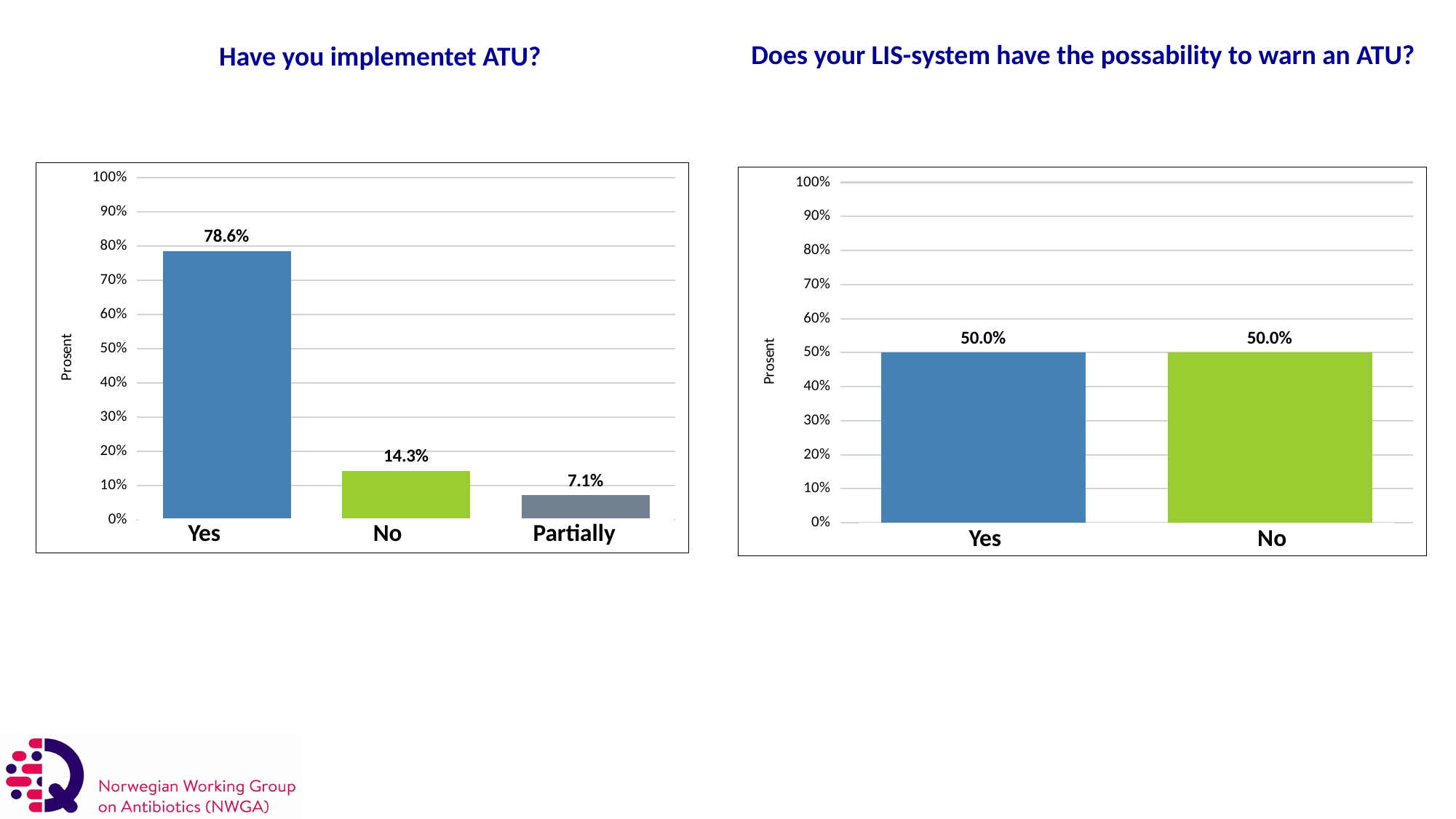
In the 'Have you implementet ATU?' chart, which category has the lowest value? Partially In the 'Does your LIS-system have the possability to warn an ATU?' chart, what is the difference between the values for Yes and No? 0.0% In the 'Have you implementet ATU?' chart, what is the difference between the values for Yes and No? 64.3% In the 'Have you implementet ATU?' chart, what is the value for Yes? 78.6% What is the y-axis label of the 'Have you implementet ATU?' chart? Prosent In the 'Have you implementet ATU?' chart, which is larger, the value for No or the value for Partially? No In the 'Have you implementet ATU?' chart, which category has the highest value? Yes What kind of chart is the 'Does your LIS-system have the possability to warn an ATU?' chart? Bar chart How many categories are shown in the 'Have you implementet ATU?' chart? 3 In the 'Does your LIS-system have the possability to warn an ATU?' chart, what is the value for No? 50.0% In the 'Have you implementet ATU?' chart, what is the value for Partially? 7.1% How many categories are shown in the 'Does your LIS-system have the possability to warn an ATU?' chart? 2